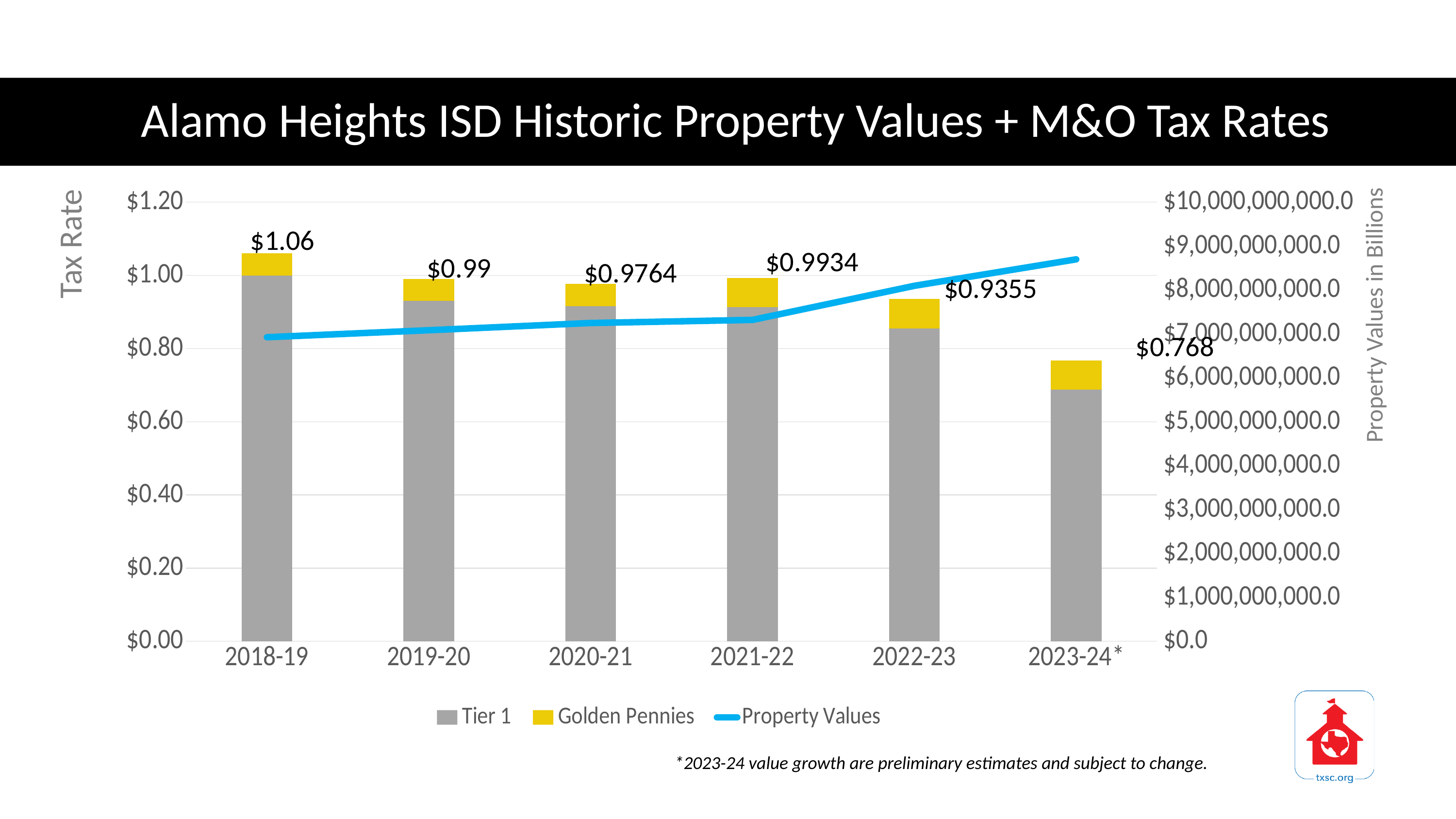
What is the difference between the total tax rate for 2018-19 and 2019-20? $0.07 How many series does the legend list? 3 What is the total M&O tax rate labeled for 2023-24*? $0.768 Is the Property Values line for 2023-24* greater or less than $8,000,000,000.0? greater Which year has the highest total tax rate bar? 2018-19 What is the total M&O tax rate labeled for 2018-19? $1.06 Which is larger, the total tax rate for 2021-22 or for 2022-23? 2021-22 Which year has the lowest total tax rate bar? 2023-24* What is the total M&O tax rate labeled for 2021-22? $0.9934 How many school years are shown on the x axis? 6 Does the Property Values line rise or fall from 2018-19 to 2023-24*? rise Which legend entry is shown in yellow? Golden Pennies